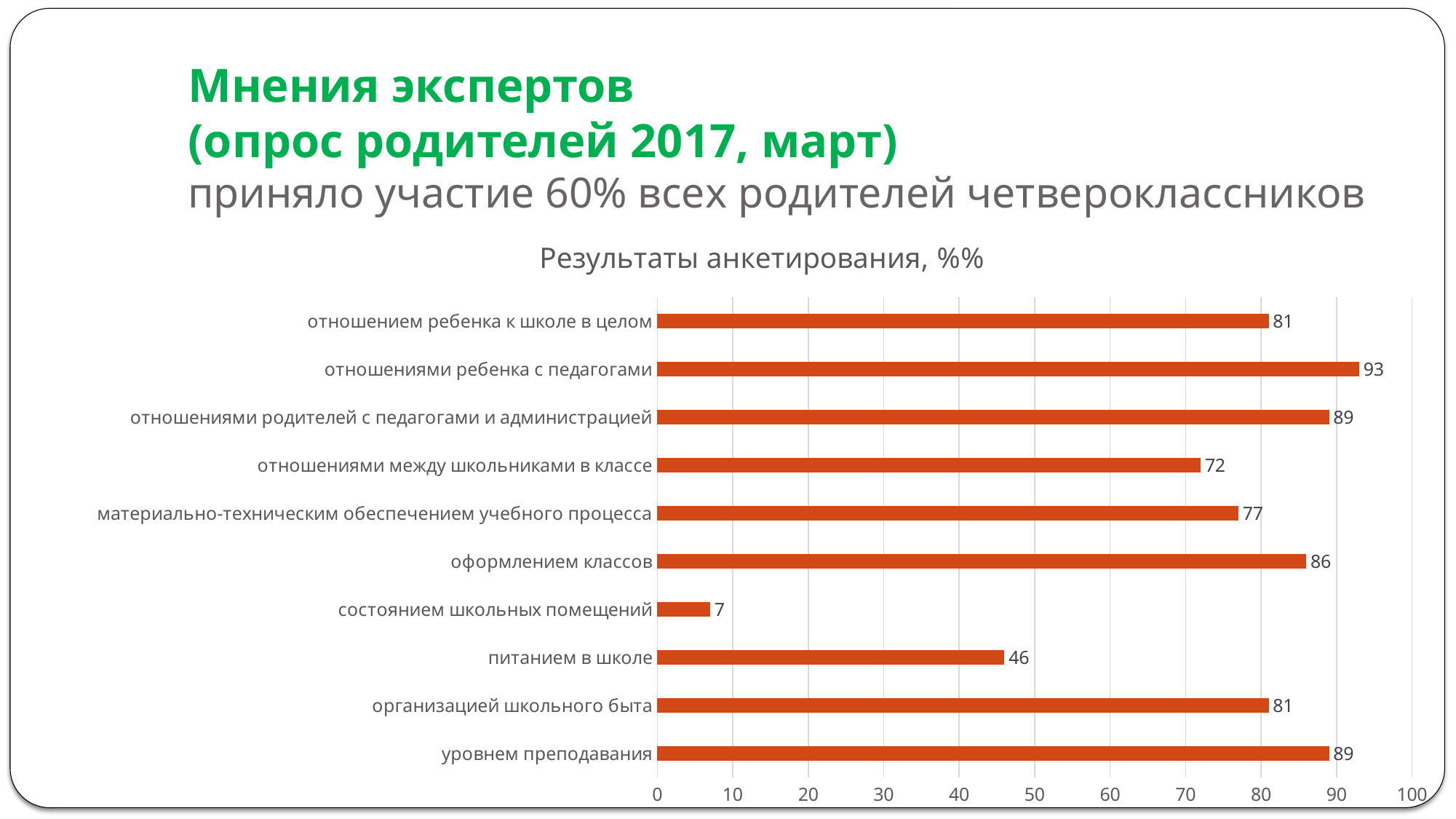
What is the value for "питанием в школе"? 46 Is the value for "питанием в школе" greater or less than 50? less What is the title of the chart? Результаты анкетирования, %% Which category has the highest value? отношениями ребенка с педагогами Which category has the lowest value? состоянием школьных помещений What is the value for "отношениями ребенка с педагогами"? 93 Which is larger: the value for "материально-техническим обеспечением учебного процесса" or the value for "оформлением классов"? оформлением классов What is the difference between the values for "отношениями ребенка с педагогами" and "отношениями между школьниками в классе"? 21 How many categories are shown in the chart? 10 What is the difference between the values for "уровнем преподавания" and "состоянием школьных помещений"? 82 What kind of chart is shown on the slide? bar chart What is the value for "оформлением классов"? 86